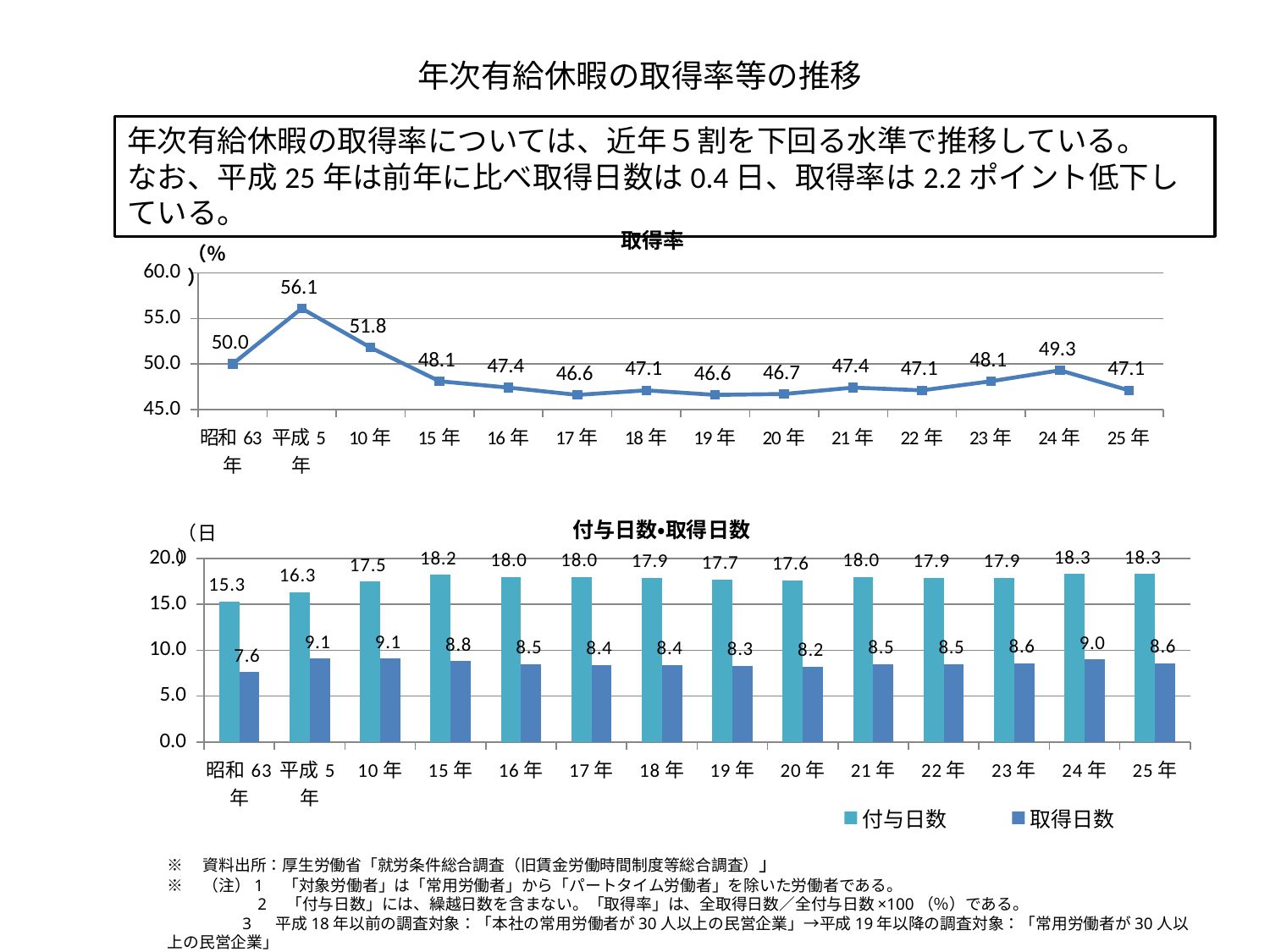
In the 取得率 chart, how many data points are plotted? 14 In the 付与日数・取得日数 chart, which year has the lowest 取得日数 value? 昭和63年 In the 取得率 chart, what is the value for 平成5年? 56.1 What kind of chart is the 付与日数・取得日数 chart? bar chart In the 取得率 chart, what is the difference between the values for 24年 and 25年? 2.2 In the 付与日数・取得日数 chart, how many series does the legend list? 2 In the 付与日数・取得日数 chart, what is the 取得日数 value for 20年? 8.2 What kind of chart is the 取得率 chart? line chart In the 取得率 chart, which year has the highest value? 平成5年 In the 取得率 chart, what is the value for 25年? 47.1 In the 付与日数・取得日数 chart, what is the 付与日数 value for 昭和63年? 15.3 In the 付与日数・取得日数 chart, what is the difference between 付与日数 and 取得日数 for 25年? 9.7